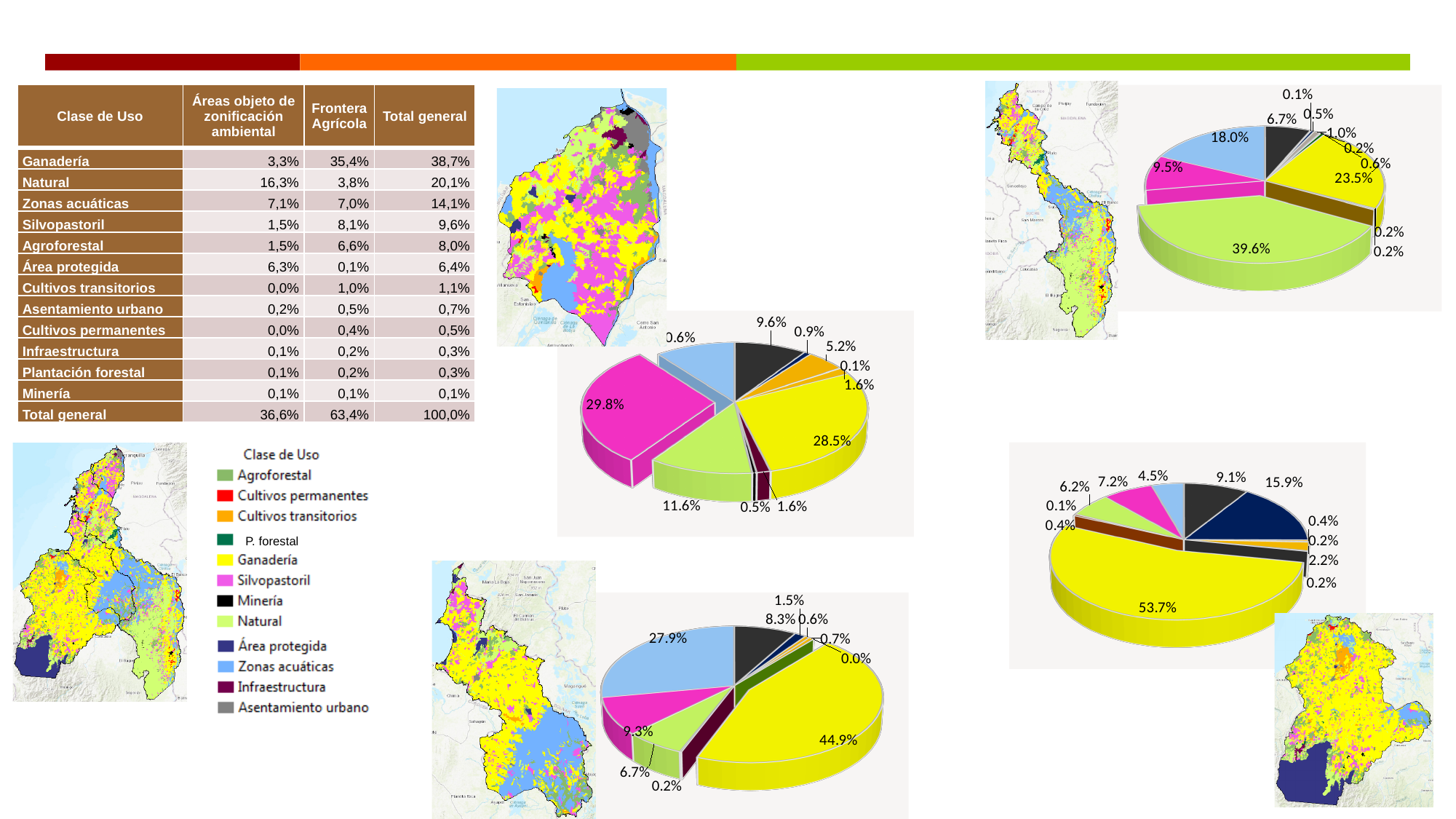
In the pie chart at the top right of the slide, what is the largest slice's value? 39.6% In the pie chart at the bottom right of the slide, what is the difference between the yellow slice (53.7%) and the dark navy slice (15.9%)? 37.8% In the pie chart at the top right of the slide, what is the difference between the light green slice (39.6%) and the yellow slice (23.5%)? 16.1% In the pie chart at the top right of the slide, what is the value of the light blue slice? 18.0% In the pie chart at the bottom right of the slide, what is the value of the largest (yellow) slice? 53.7% In the pie chart at the top center of the slide, what is the value of the magenta slice? 29.8% In the pie chart at the bottom center of the slide, what is the value of the largest slice? 44.9% In the pie chart at the bottom right of the slide, what is the value of the dark navy slice? 15.9% In the pie chart at the bottom center of the slide, which is larger: the magenta slice (9.3%) or the black slice (8.3%)? The magenta slice (9.3%) What kind of charts are the four charts on the slide? Pie charts In the pie chart at the top center of the slide, what is the value of the yellow slice? 28.5% In the pie chart at the bottom center of the slide, what is the value of the light blue slice? 27.9%